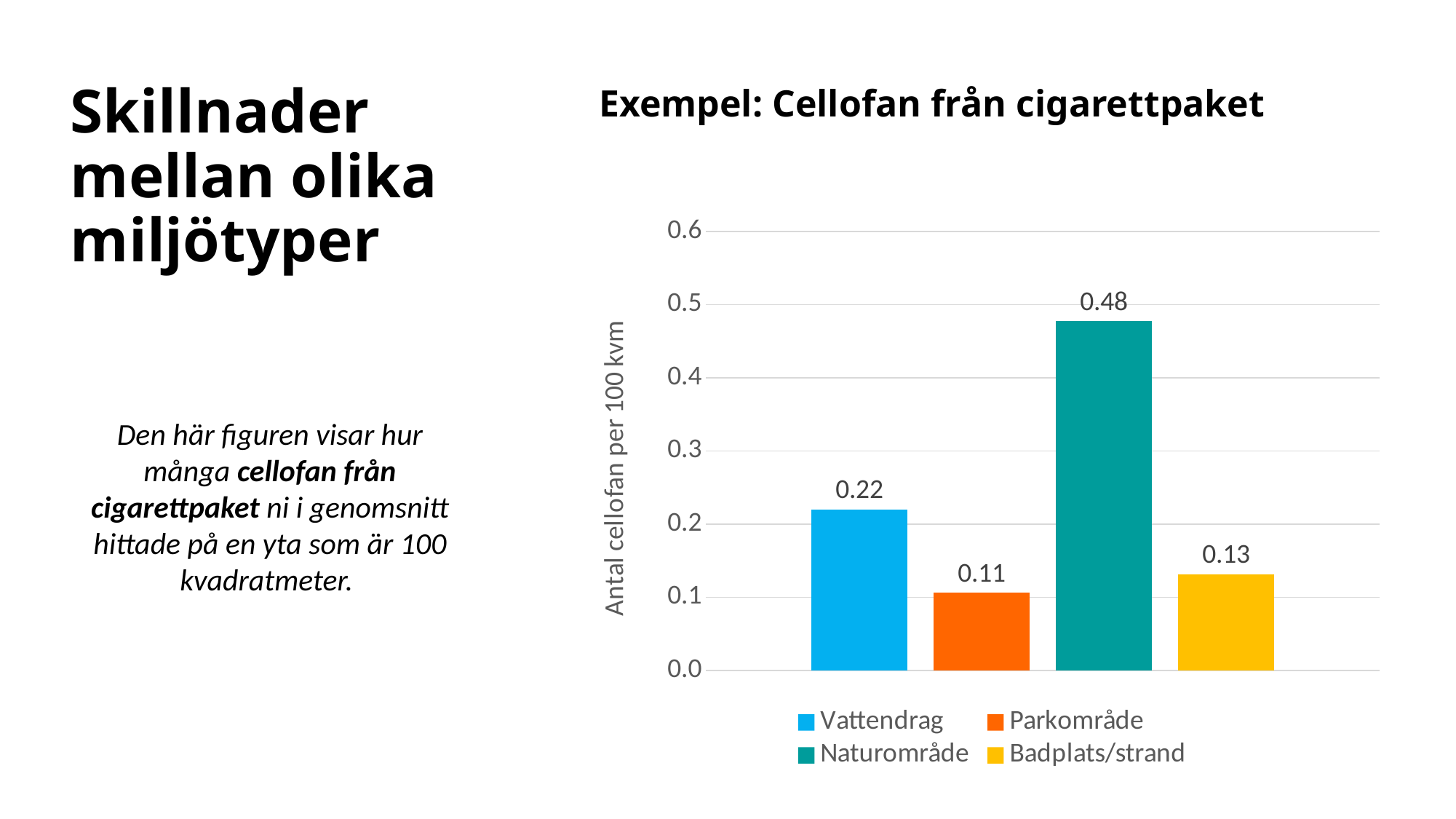
What is the value for Parkområde? 0.11 Which category has the lowest value? Parkområde Which category has the highest value? Naturområde Is the value for Naturområde greater or less than 0.4? greater What is the difference between the values for Naturområde and Vattendrag? 0.26 What is the value for Badplats/strand? 0.13 What is the value for Naturområde? 0.48 How many bars are shown in the chart? 4 What is the value for Vattendrag? 0.22 What is the title of the chart? Exempel: Cellofan från cigarettpaket What kind of chart is shown on the slide? bar chart Which is larger, the value for Vattendrag or the value for Badplats/strand? Vattendrag